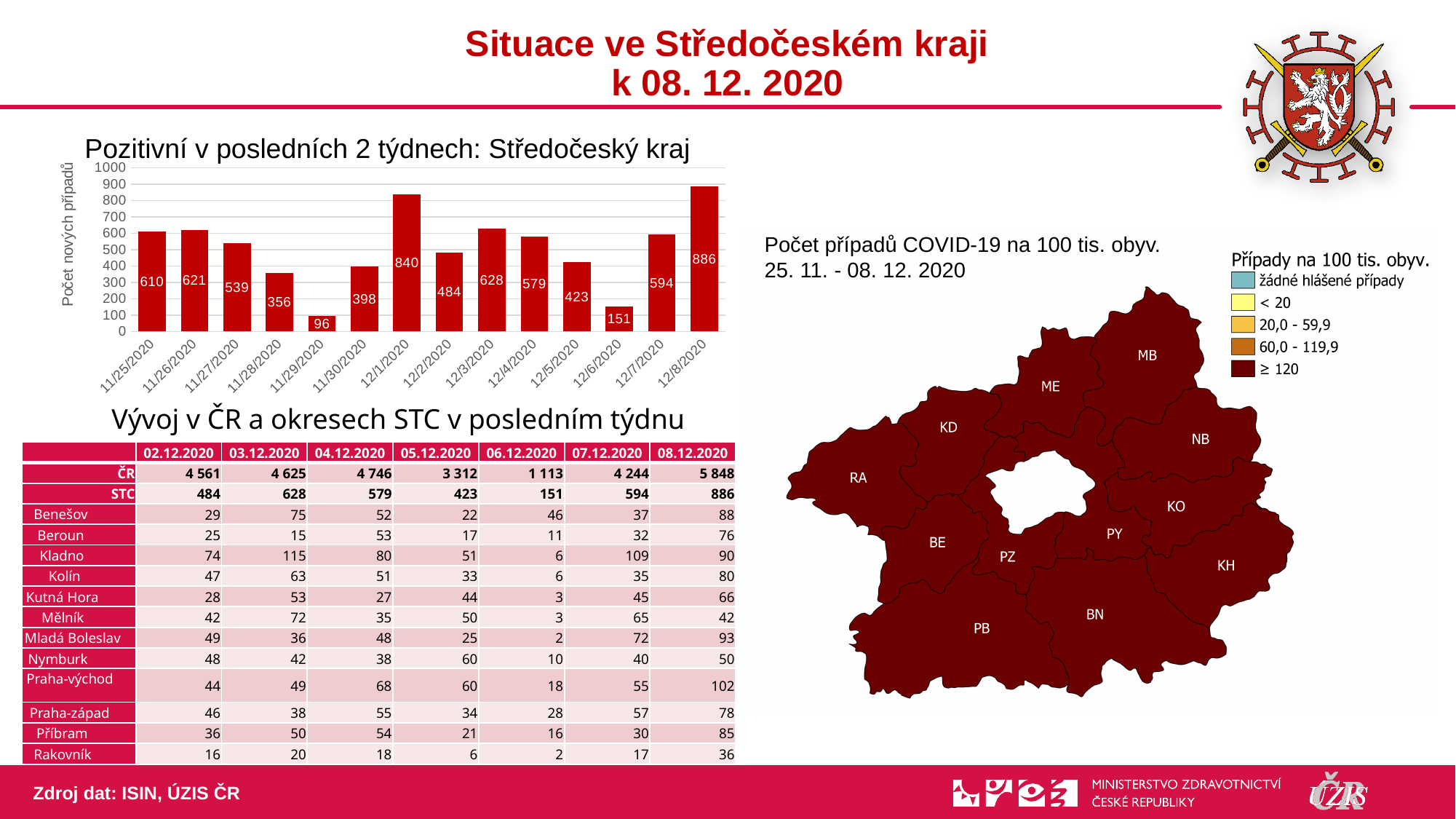
In the bar chart, is the value for 12/1/2020 greater or less than 800? greater In the bar chart, what is the difference between the values for 12/8/2020 and 12/1/2020? 46 What is the label of the vertical axis of the bar chart? Počet nových případů In the bar chart, what is the value for 12/1/2020? 840 What type of chart is shown under the title 'Pozitivní v posledních 2 týdnech: Středočeský kraj'? bar chart In the bar chart, what is the value for 12/6/2020? 151 Which date has the lowest value in the bar chart? 11/29/2020 In the bar chart, do the values rise or fall from 11/26/2020 to 11/29/2020? fall Which date has the highest value in the bar chart? 12/8/2020 In the bar chart, which is larger: the value for 12/3/2020 or 12/4/2020? 12/3/2020 How many dates (bars) are shown in the bar chart? 14 In the bar chart, what is the value for 11/29/2020? 96